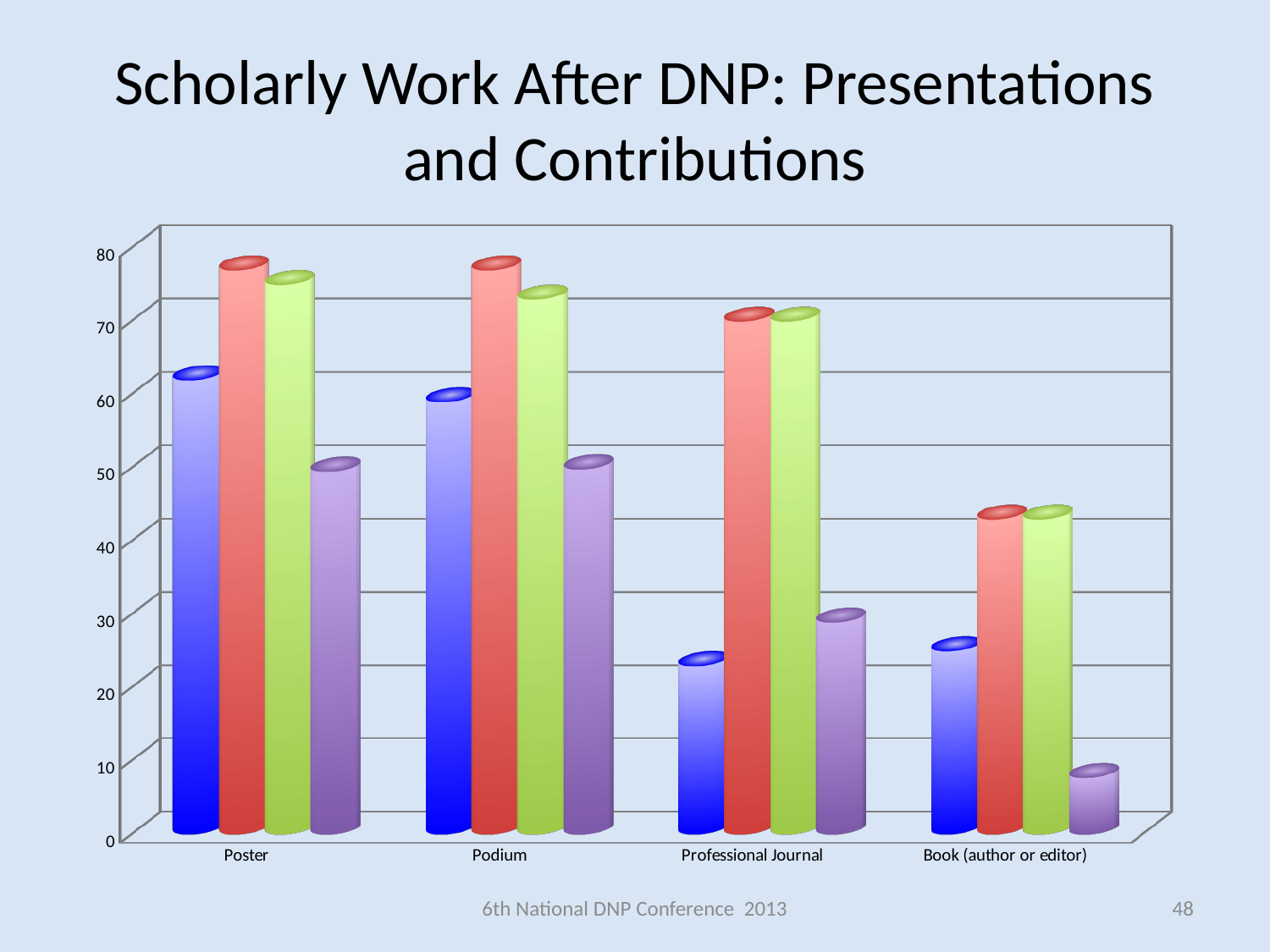
How many bars are plotted for each category in the chart? 4 Is the value of the green bar for Professional Journal greater or less than 60? greater For Poster, which is larger: the red bar or the purple bar? the red bar Which category has the shortest purple bar? Book (author or editor) Is the value of the blue bar for Professional Journal greater or less than 30? less Is the value of the purple bar for Podium greater or less than 60? less What is the title of the chart on the slide? Scholarly Work After DNP: Presentations and Contributions How many categories are shown on the x axis of the chart? 4 What kind of chart is shown on the slide? bar chart For Book (author or editor), which is larger: the green bar or the blue bar? the green bar